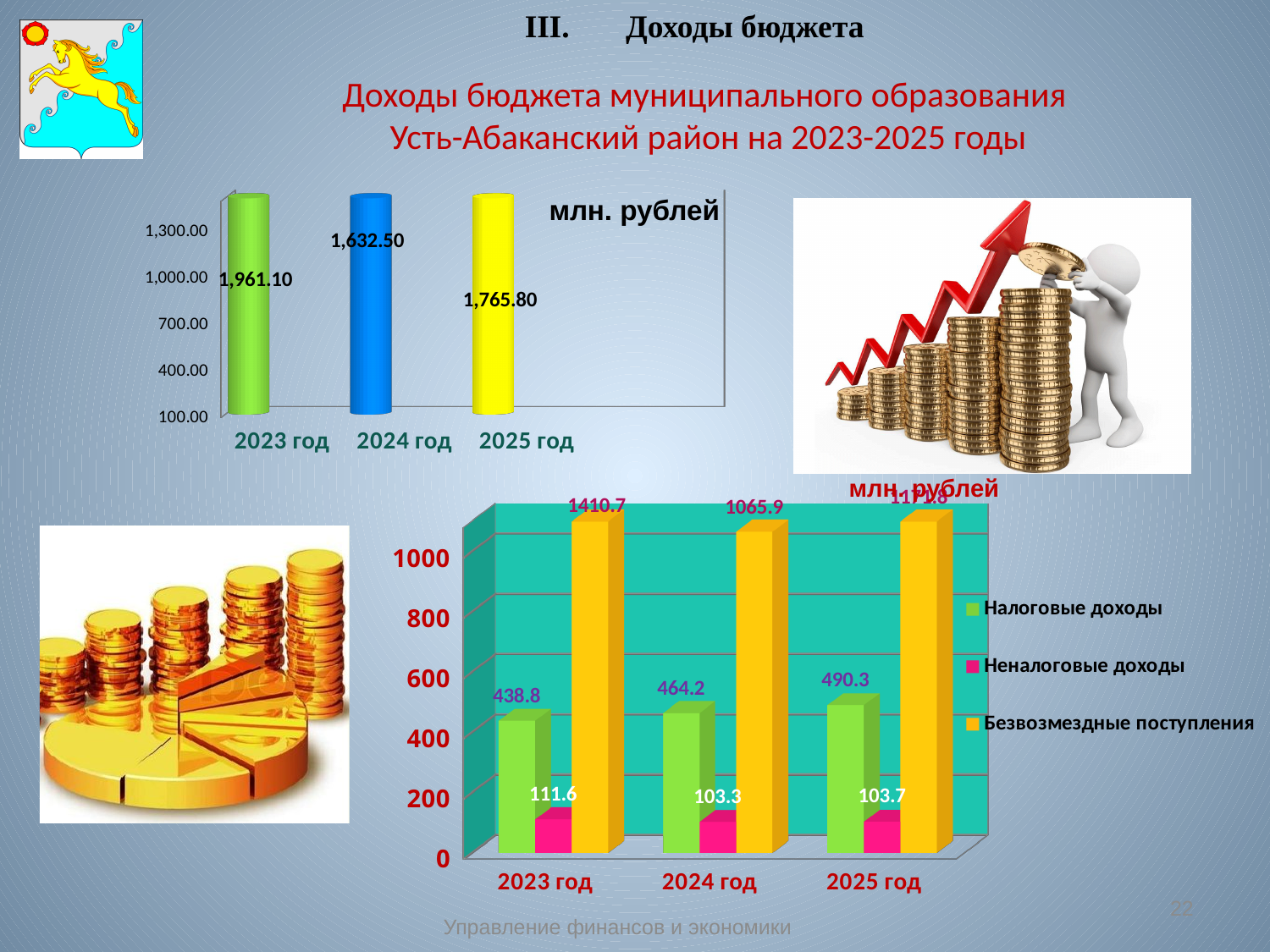
In the bottom chart, how many series does the legend list? 3 In the top chart, which year has the highest value? 2023 год In the top chart, how many years are shown? 3 In the bottom chart, do the values of Налоговые доходы rise or fall from 2023 год to 2025 год? rise What kind of chart is the bottom chart? bar chart In the top chart, which year has the lowest value? 2024 год In the top chart, what is the value for 2025 год? 1,765.80 In the bottom chart, what is the value of Неналоговые доходы for 2023 год? 111.6 In the bottom chart, what is the value of Налоговые доходы for 2025 год? 490.3 In the top chart, what is the value for 2024 год? 1,632.50 In the bottom chart, which is larger for 2024 год: Налоговые доходы or Неналоговые доходы? Налоговые доходы In the bottom chart, what is the value of Безвозмездные поступления for 2024 год? 1065.9